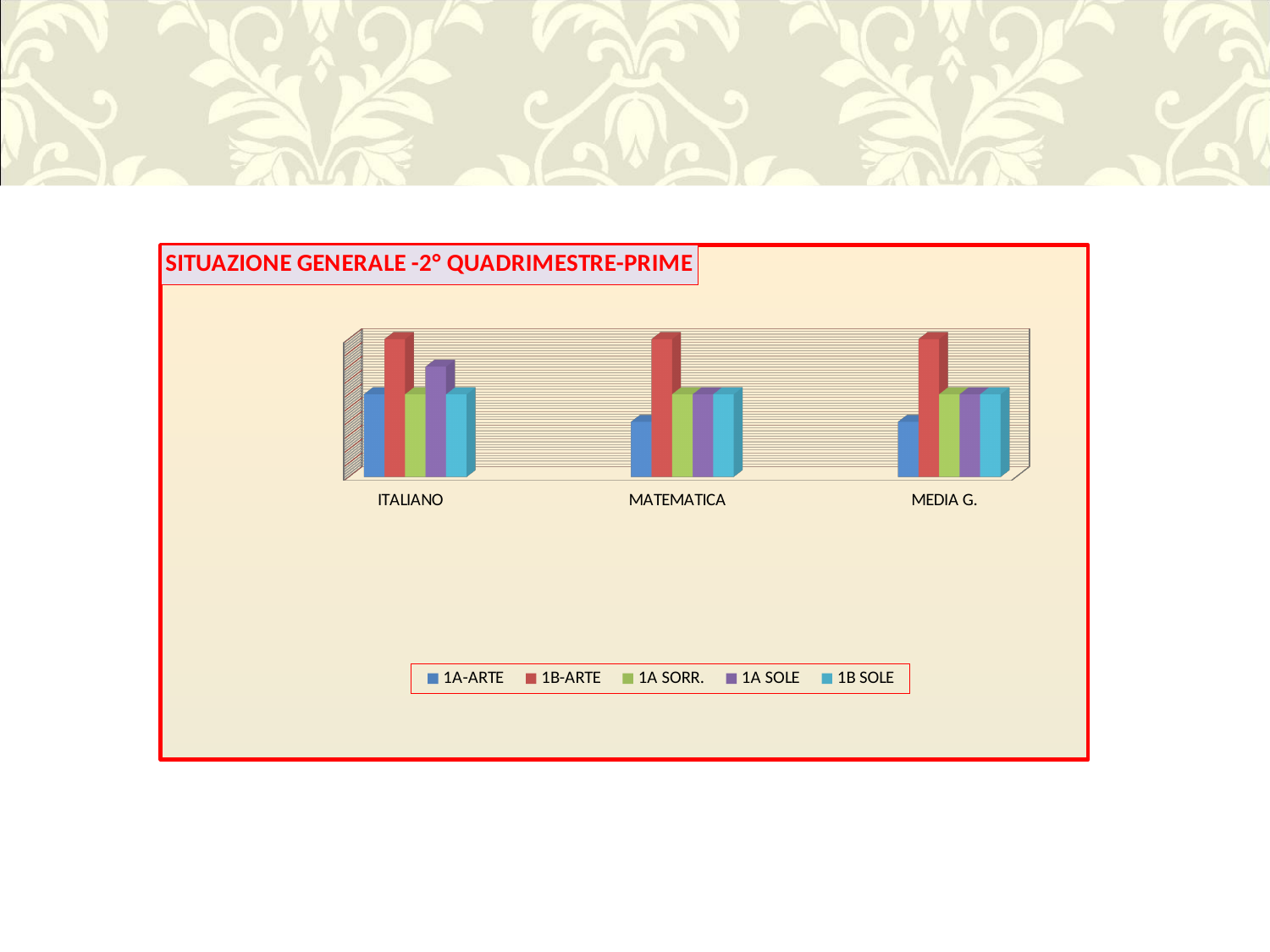
In the MEDIA G. category, which is larger: the bar for 1B-ARTE or the bar for 1A-ARTE? 1B-ARTE Which series has the lowest bar in the MEDIA G. category? 1A-ARTE What is the title of the chart? SITUAZIONE GENERALE -2° QUADRIMESTRE-PRIME What kind of chart is shown on the slide? Bar chart Which series has the lowest bar in the MATEMATICA category? 1A-ARTE Which series is shown in red in the chart's legend? 1B-ARTE How many series does the chart's legend list? 5 Which series has the highest bar in the MEDIA G. category? 1B-ARTE Which series has the highest bar in the ITALIANO category? 1B-ARTE Which series has the highest bar in the MATEMATICA category? 1B-ARTE In the ITALIANO category, which is larger: the bar for 1A SOLE or the bar for 1A-ARTE? 1A SOLE How many categories are shown on the x axis of the chart? 3